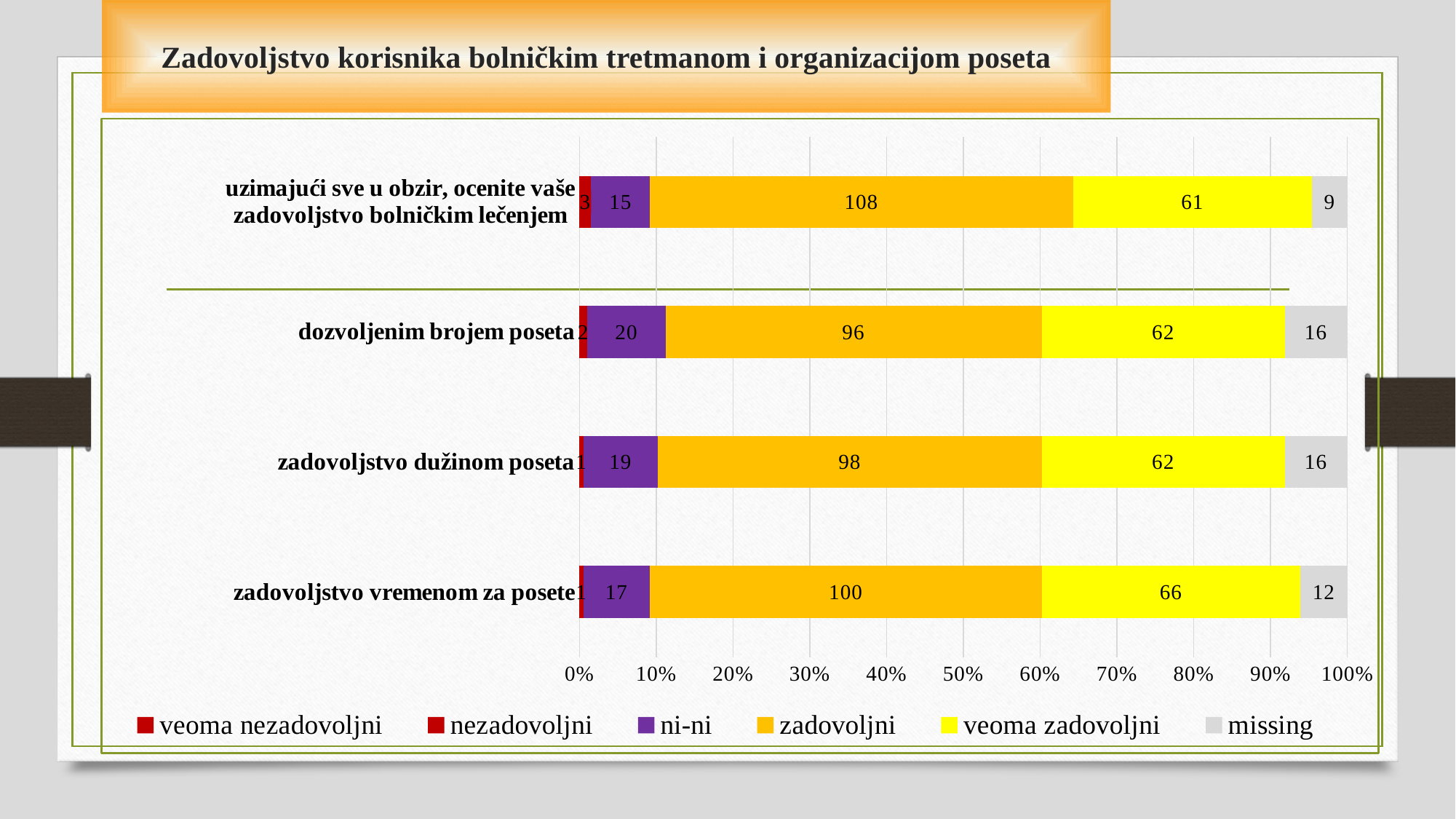
Which is larger: the 'ni-ni' value for 'zadovoljstvo dužinom poseta' or for 'zadovoljstvo vremenom za posete'? zadovoljstvo dužinom poseta What is the 'zadovoljni' value for 'uzimajući sve u obzir, ocenite vaše zadovoljstvo bolničkim lečenjem'? 108 How many categories are shown on the chart? 4 Which category has the lowest 'missing' value? uzimajući sve u obzir, ocenite vaše zadovoljstvo bolničkim lečenjem Which category has the highest 'zadovoljni' value? uzimajući sve u obzir, ocenite vaše zadovoljstvo bolničkim lečenjem What type of chart is shown on the slide? stacked bar chart What is the 'veoma zadovoljni' value for 'zadovoljstvo vremenom za posete'? 66 What is the difference between the 'zadovoljni' values for 'zadovoljstvo vremenom za posete' and 'dozvoljenim brojem poseta'? 4 What is the 'ni-ni' value for 'dozvoljenim brojem poseta'? 20 What is the title of the slide? Zadovoljstvo korisnika bolničkim tretmanom i organizacijom poseta What is the 'missing' value for 'zadovoljstvo dužinom poseta'? 16 How many series does the legend list? 6